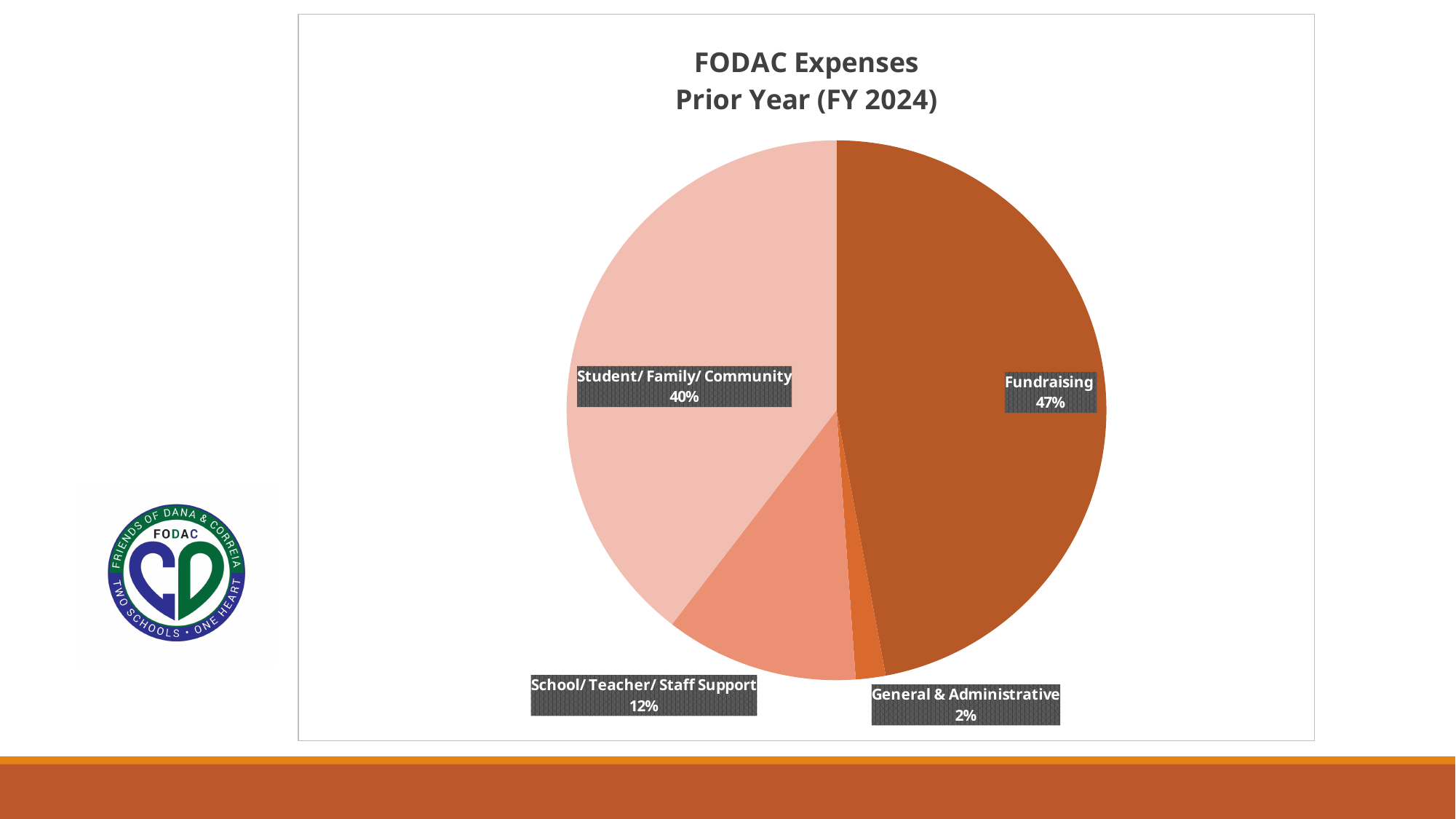
Which category has the largest share of expenses? Fundraising Which category has the smallest share of expenses? General & Administrative Which is larger, School/ Teacher/ Staff Support or General & Administrative? School/ Teacher/ Staff Support What is the difference in percentage points between Student/ Family/ Community and School/ Teacher/ Staff Support? 28 What share of expenses is Student/ Family/ Community? 40% What share of expenses is School/ Teacher/ Staff Support? 12% What is the title of the chart? FODAC Expenses Prior Year (FY 2024) What share of expenses is General & Administrative? 2% What share of expenses is Fundraising? 47% What kind of chart is shown on the slide? pie chart What is the difference in percentage points between Fundraising and Student/ Family/ Community? 7 How many categories are shown in the pie chart? 4